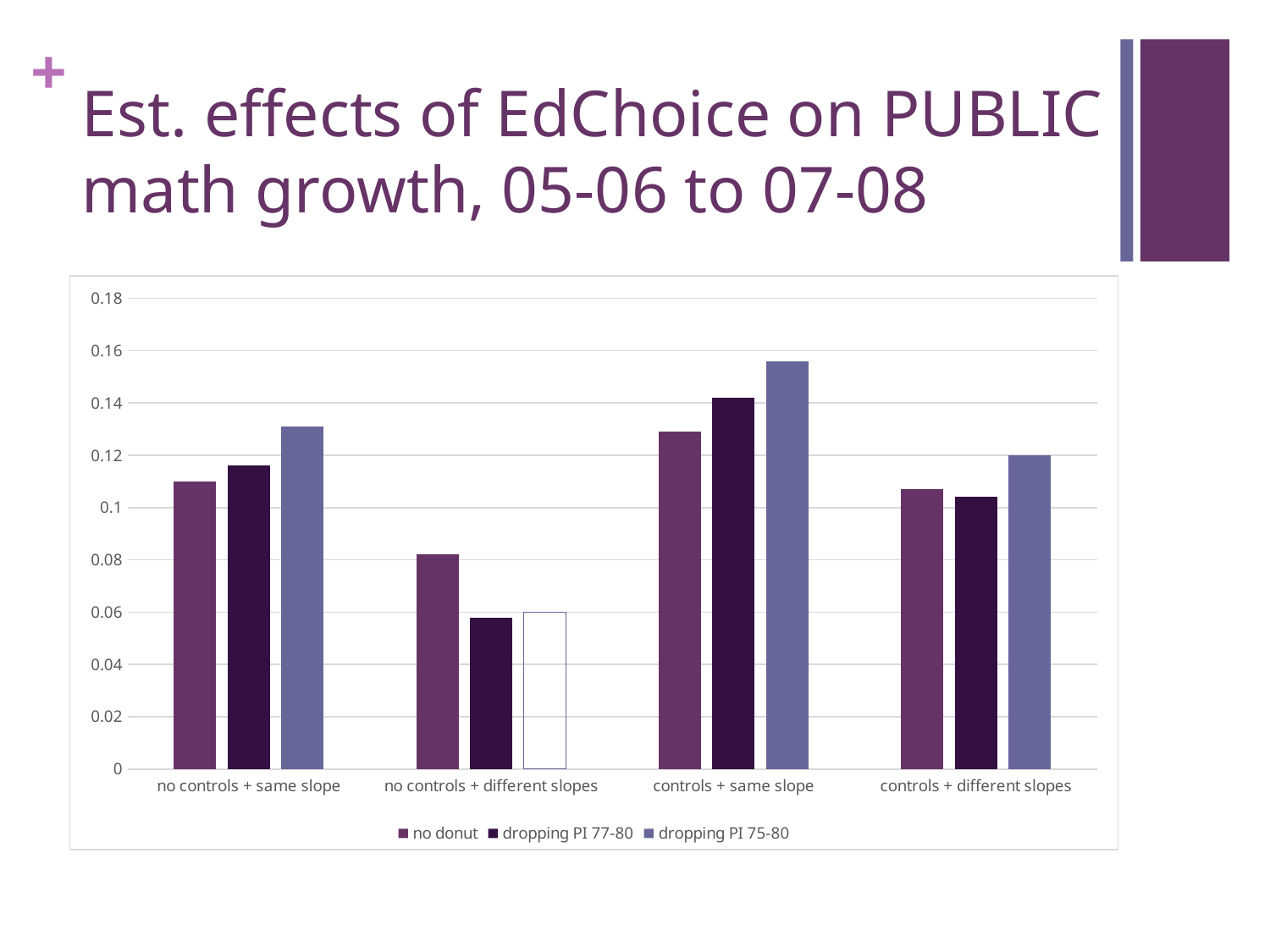
Which category has the lowest value for the 'no donut' series? no controls + different slopes How many categories are shown on the x axis of the chart? 4 Which category has the highest value for the 'dropping PI 75-80' series? controls + same slope What kind of chart is shown on the slide? bar chart Is the value for 'dropping PI 75-80' at 'controls + same slope' greater or less than 0.14? greater At 'controls + same slope', which is larger: the 'no donut' value or the 'dropping PI 77-80' value? dropping PI 77-80 What is the title of the slide containing the chart? Est. effects of EdChoice on PUBLIC math growth, 05-06 to 07-08 Is the value for 'no donut' at 'no controls + different slopes' greater or less than 0.1? less At 'no controls + same slope', which is larger: the 'no donut' value or the 'dropping PI 75-80' value? dropping PI 75-80 Is the value for 'no donut' at 'no controls + same slope' greater or less than 0.1? greater How many series does the chart's legend list? 3